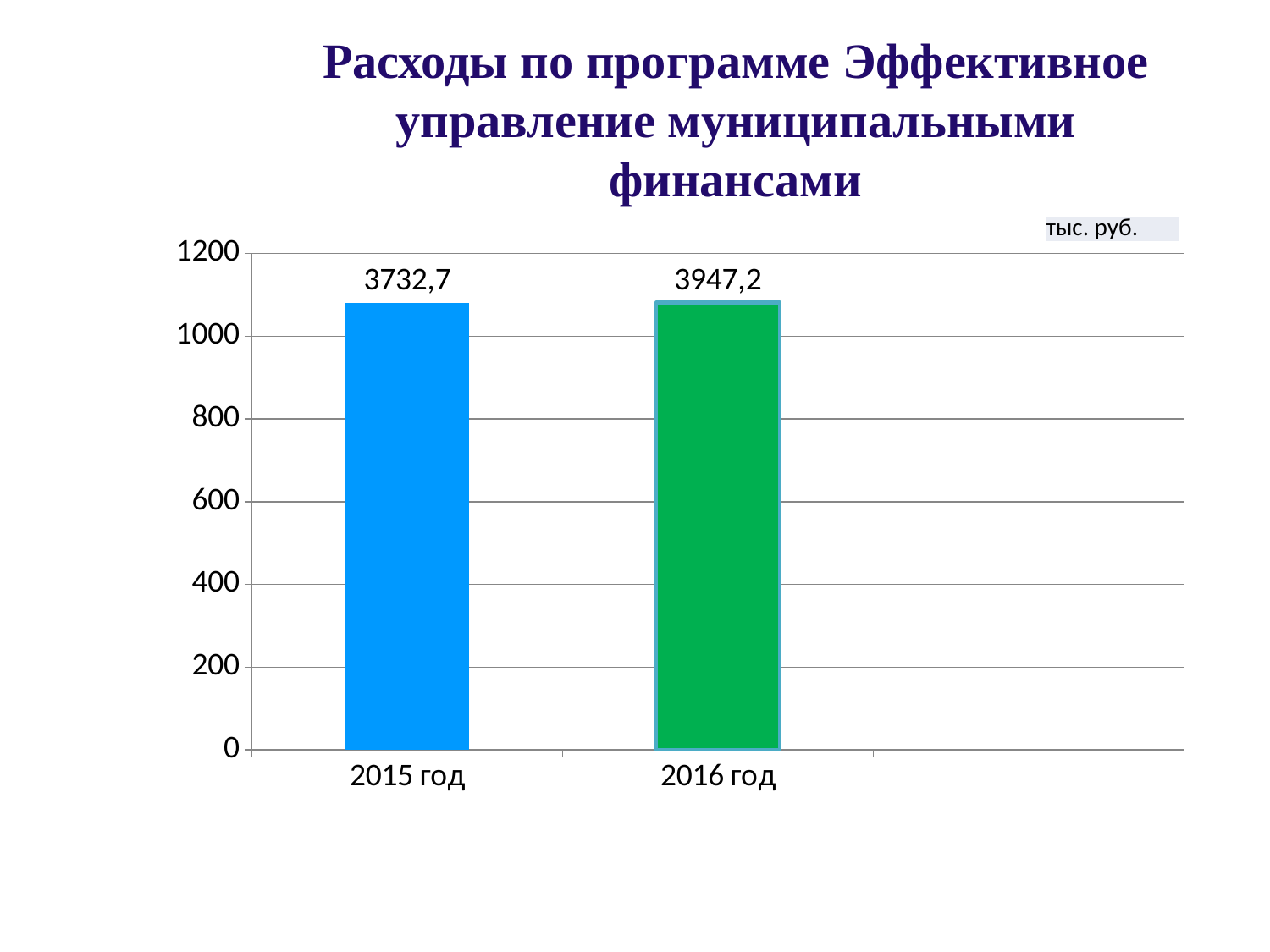
What kind of chart is shown on the slide? bar chart Which year has the lower value according to the data labels? 2015 год What is the value shown for 2016 год? 3947,2 How many categories (years) are shown on the chart? 2 What is the value shown for 2015 год? 3732,7 What unit is indicated for the values on the chart? тыс. руб. Which year has the higher value according to the data labels? 2016 год What is the difference between the values for 2016 год and 2015 год? 214,5 What colour is the bar for 2016 год? green